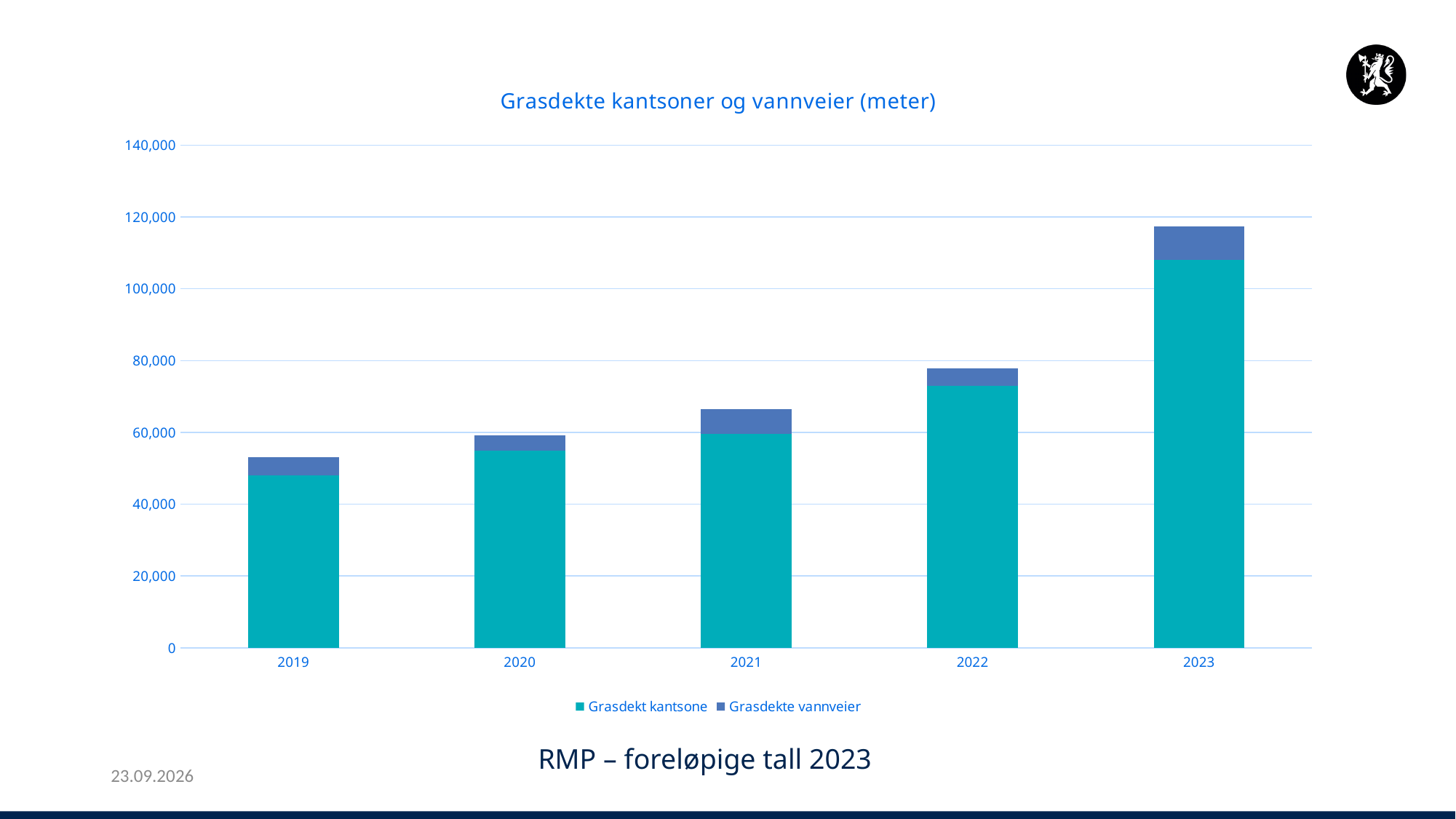
Is the total value for 2019 greater or less than 60,000? less Do the total bar values rise or fall from 2019 to 2023? rise What kind of chart is shown on the slide? stacked bar chart Which year has the highest total bar? 2023 How many series does the legend list? 2 Which year has the lowest total bar? 2019 Which is larger, the total bar for 2021 or the total bar for 2022? 2022 Is the Grasdekt kantsone value for 2023 greater or less than 100,000? greater Is the total value for 2023 greater or less than 100,000? greater How many years are shown on the x axis? 5 What is the title of the chart? Grasdekte kantsoner og vannveier (meter)